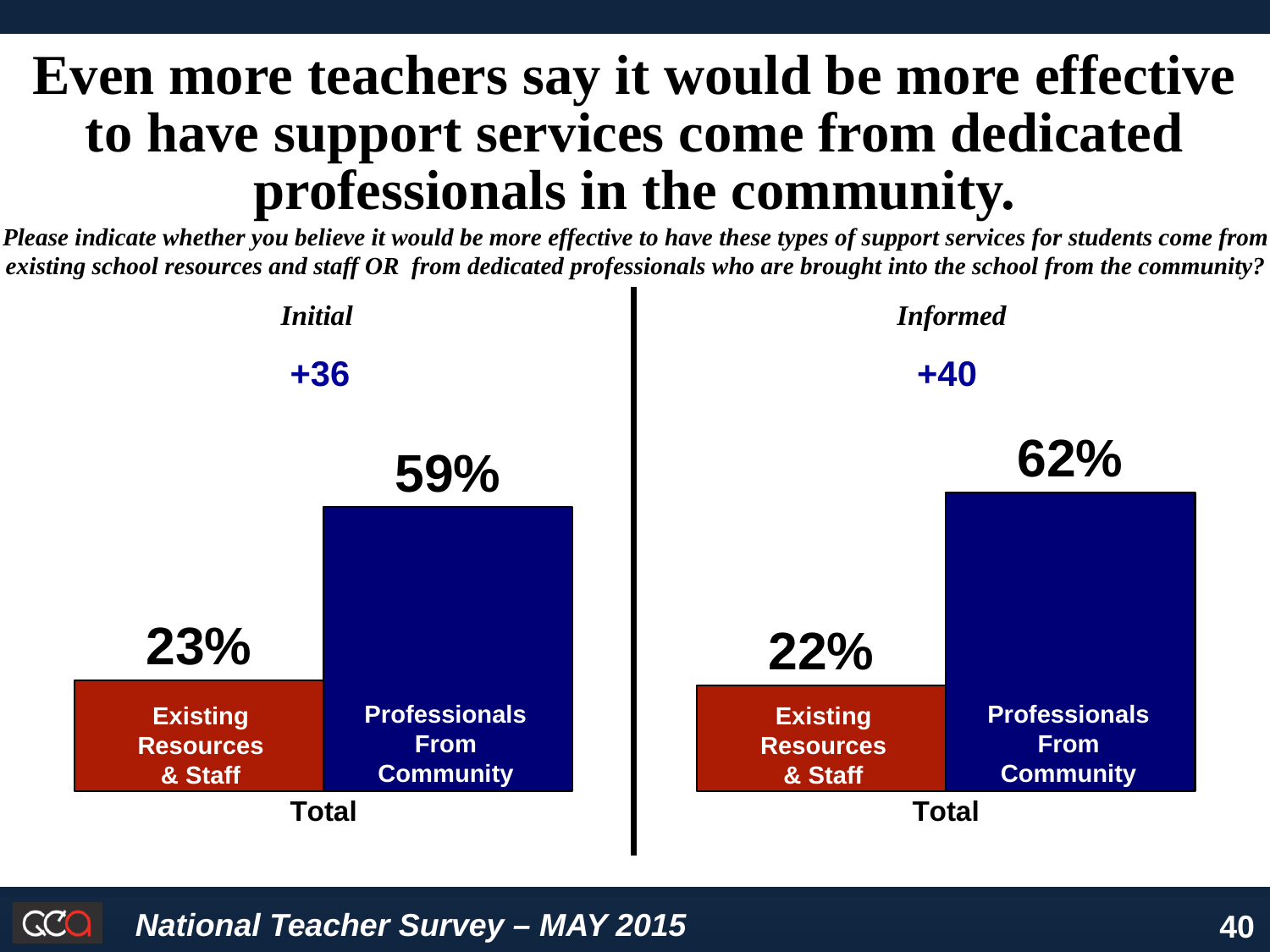
In the Initial chart, what is the difference between Professionals From Community and Existing Resources & Staff? 36 What colour is the Existing Resources & Staff bar in the Initial chart? Red In the Informed chart, what percentage is shown for Professionals From Community? 62% In the Initial chart, which category has the higher value? Professionals From Community Is the value for Professionals From Community larger in the Initial chart or the Informed chart? Informed How many bars are shown in the Informed chart? 2 In the Informed chart, what percentage is shown for Existing Resources & Staff? 22% In the Initial chart, what percentage is shown for Existing Resources & Staff? 23% In the Informed chart, what is the difference between Professionals From Community and Existing Resources & Staff? 40 In the Initial chart, what percentage is shown for Professionals From Community? 59% In the Informed chart, which category has the lower value? Existing Resources & Staff What type of chart is used on this slide? Bar chart